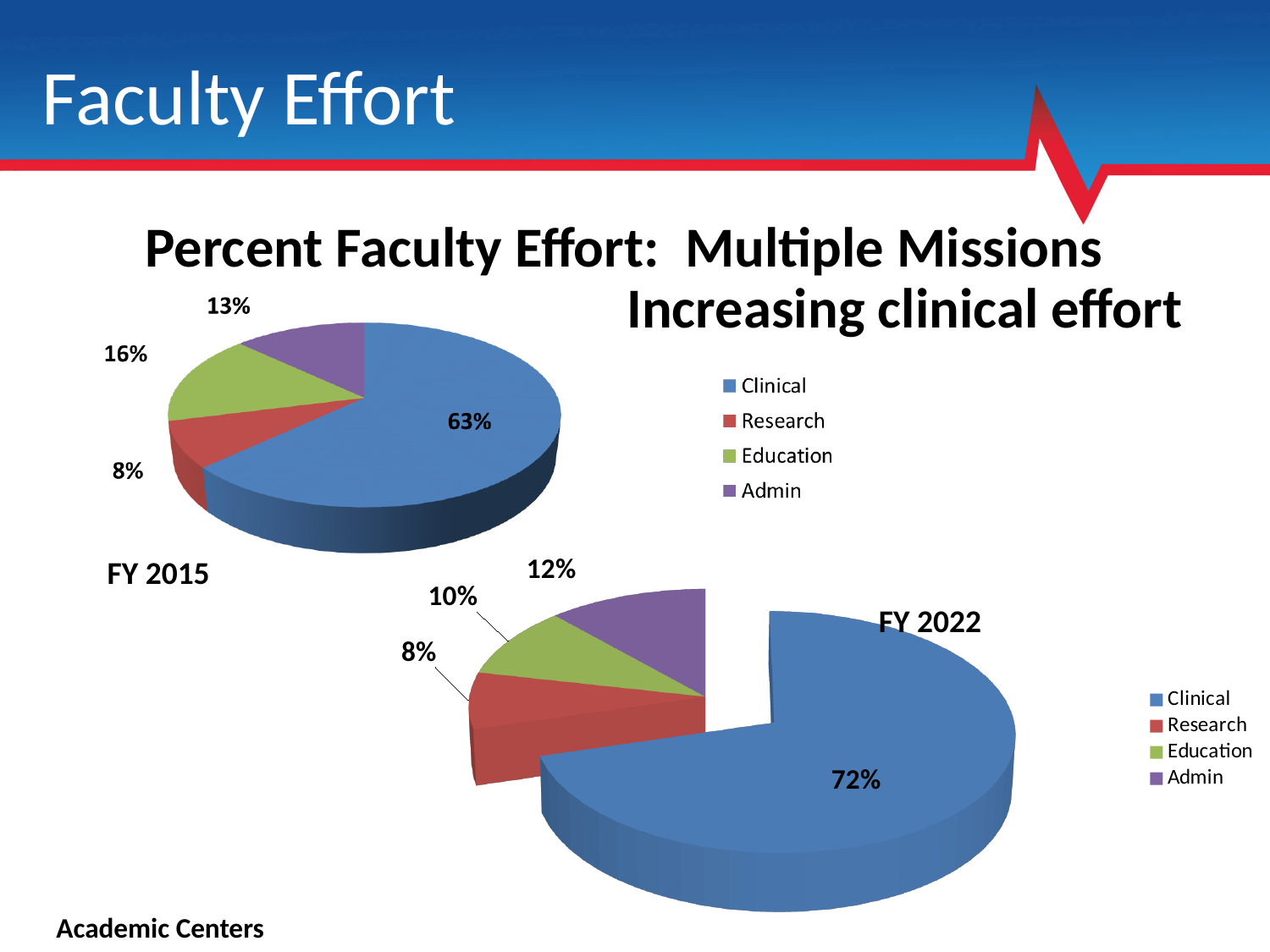
In the FY 2015 pie chart, what percentage of faculty effort is Research? 8% In the FY 2022 pie chart, what percentage of faculty effort is Admin? 12% In the FY 2015 pie chart, what percentage of faculty effort is Clinical? 63% By how many percentage points did the Clinical share increase from FY 2015 to FY 2022? 9 What colour represents Admin in the pie charts? Purple What type of chart is used to show faculty effort for FY 2015 and FY 2022? Pie chart In the FY 2015 pie chart, what percentage of faculty effort is Education? 16% In the FY 2015 pie chart, which category has the smallest share? Research In the FY 2022 pie chart, what percentage of faculty effort is Clinical? 72% How many categories does the legend of the FY 2022 pie chart list? 4 Which is larger: the Education share in FY 2015 or the Education share in FY 2022? FY 2015 In the FY 2022 pie chart, which category has the largest share? Clinical